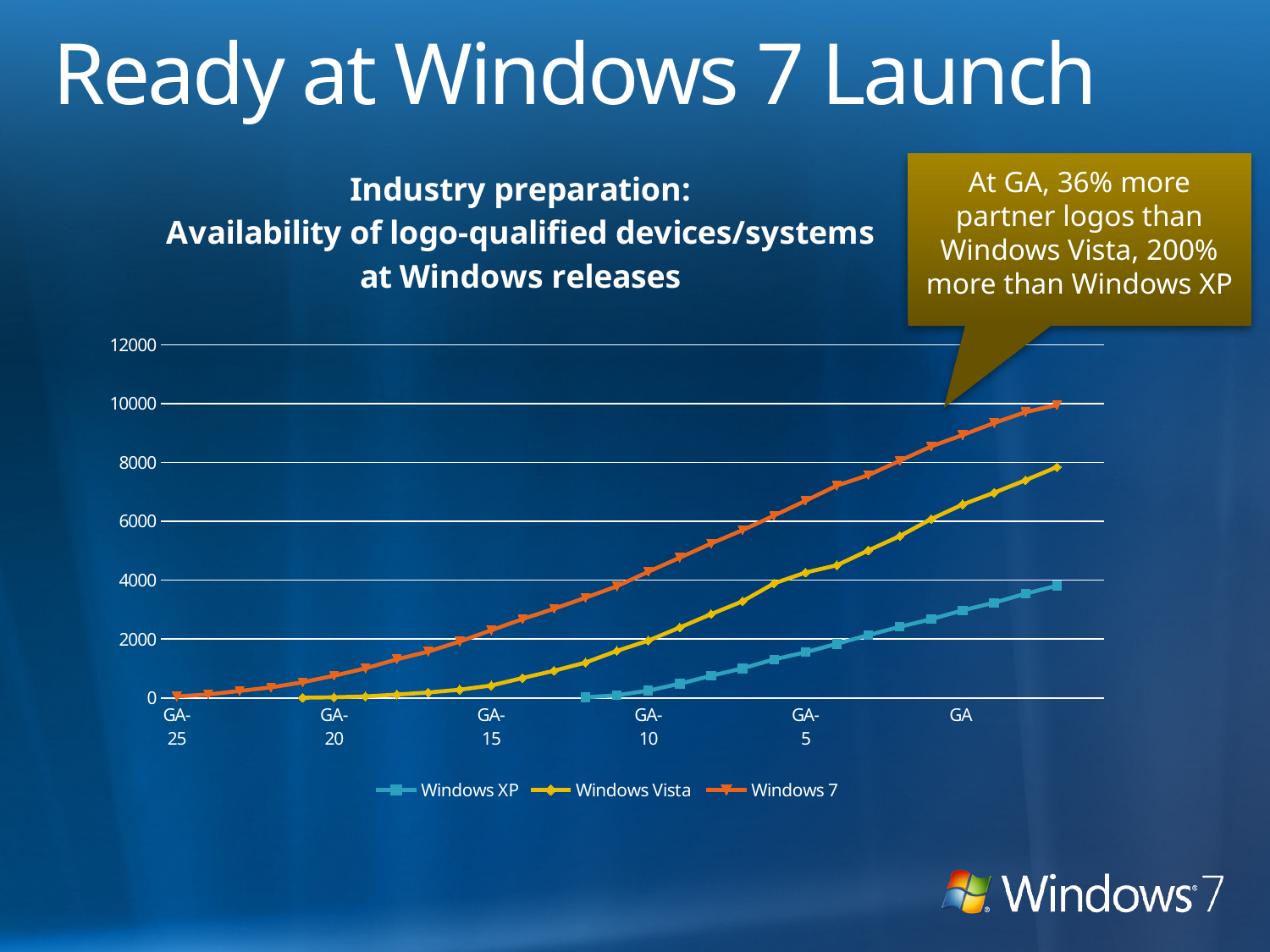
Is the value for Windows 7 at GA-10 greater or less than 4000? greater What kind of chart is shown on the slide? line chart How many labelled categories are shown on the x axis? 6 Which series has the lowest value at GA? Windows XP How many series does the legend list? 3 Is the value for Windows XP at GA greater or less than 4000? less What is the title of the chart? Industry preparation: Availability of logo-qualified devices/systems at Windows releases At GA-5, which is larger: the value for Windows Vista or the value for Windows XP? Windows Vista Do the values for Windows 7 rise or fall from GA-25 to GA? rise Which series are listed in the chart legend? Windows XP, Windows Vista, Windows 7 Which series has the highest value at GA? Windows 7 Is the value for Windows Vista at GA greater or less than 6000? greater